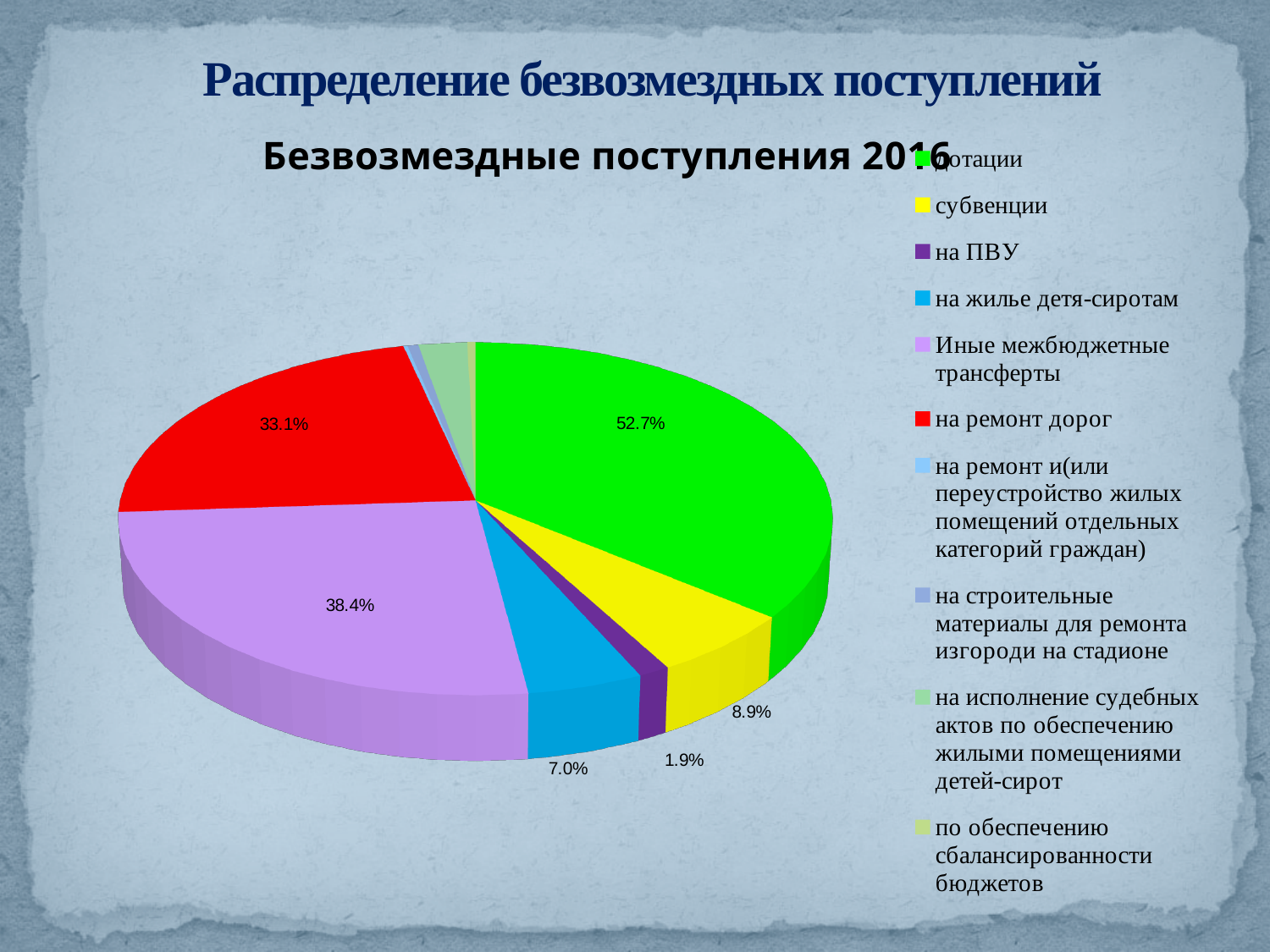
Which category has the largest slice in the pie chart? дотации What percentage is shown for на жилье детя-сиротам? 7.0% Which is larger, субвенции or на жилье детя-сиротам? субвенции What percentage is shown for дотации? 52.7% What percentage is shown for Иные межбюджетные трансферты? 38.4% What percentage is shown for субвенции? 8.9% What percentage is shown for на ремонт дорог? 33.1% What percentage is shown for на ПВУ? 1.9% How many entries does the chart legend list? 10 What kind of chart is shown on the slide? pie chart What is the title of the chart? Безвозмездные поступления 2016 What is the difference in percentage points between дотации and Иные межбюджетные трансферты? 14.3